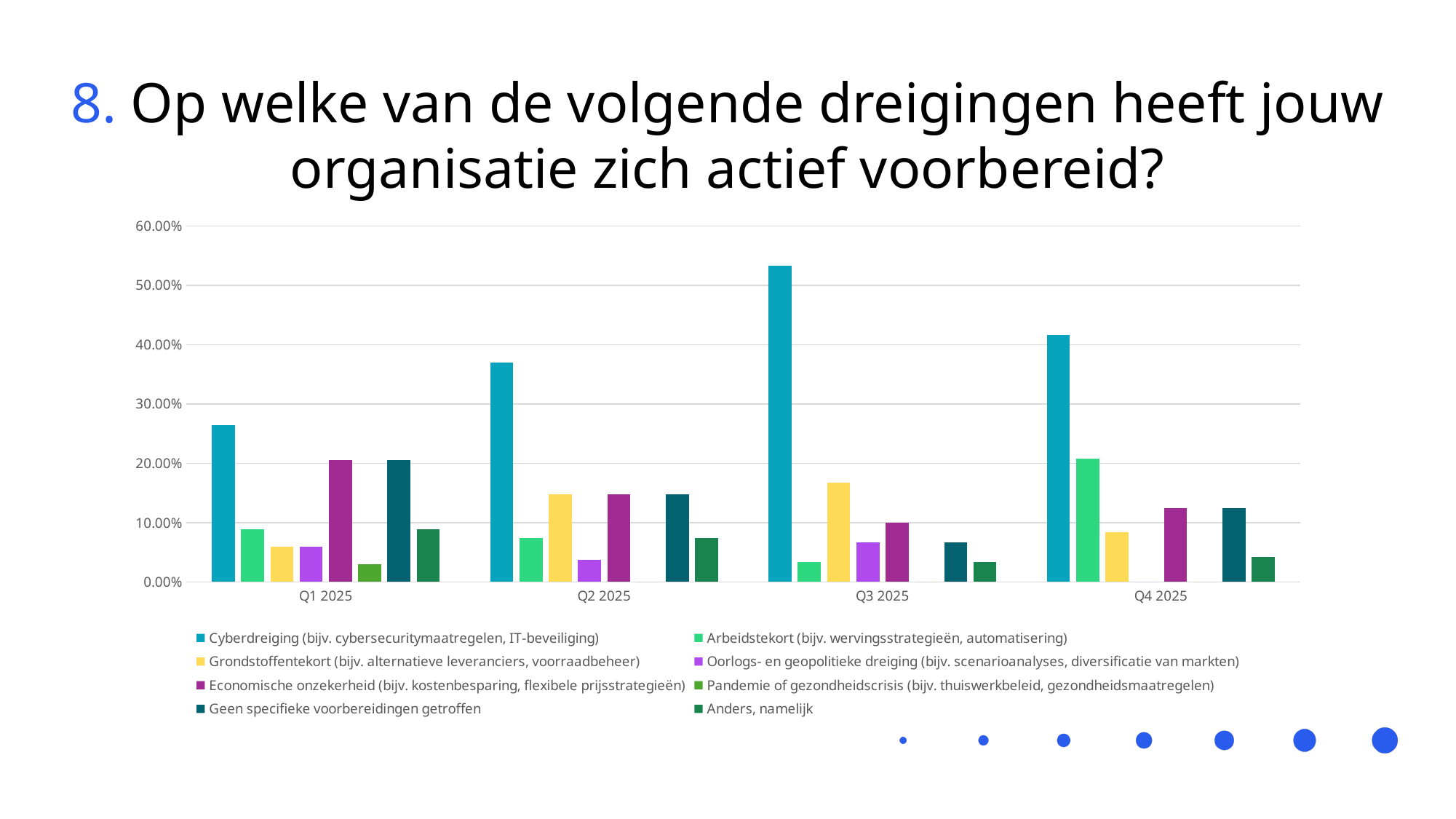
Is the value for Cyberdreiging in Q3 2025 greater or less than 50.00%? greater How many series does the legend list? 8 In which quarter is the value for Cyberdreiging the highest? Q3 2025 In which quarter is the value for Arbeidstekort the lowest? Q3 2025 What kind of chart is shown on the slide? Bar chart Is the value for Cyberdreiging in Q1 2025 greater or less than 30.00%? less Which legend entry is shown in yellow? Grondstoffentekort (bijv. alternatieve leveranciers, voorraadbeheer) Which is larger: the value for Arbeidstekort in Q4 2025 or in Q1 2025? Q4 2025 Does the value for Cyberdreiging rise or fall from Q1 2025 to Q3 2025? Rises In Q4 2025, which series has the highest value? Cyberdreiging (bijv. cybersecuritymaatregelen, IT-beveiliging) Is the value for Grondstoffentekort in Q3 2025 greater or less than 10.00%? greater How many quarters are shown on the x axis? 4